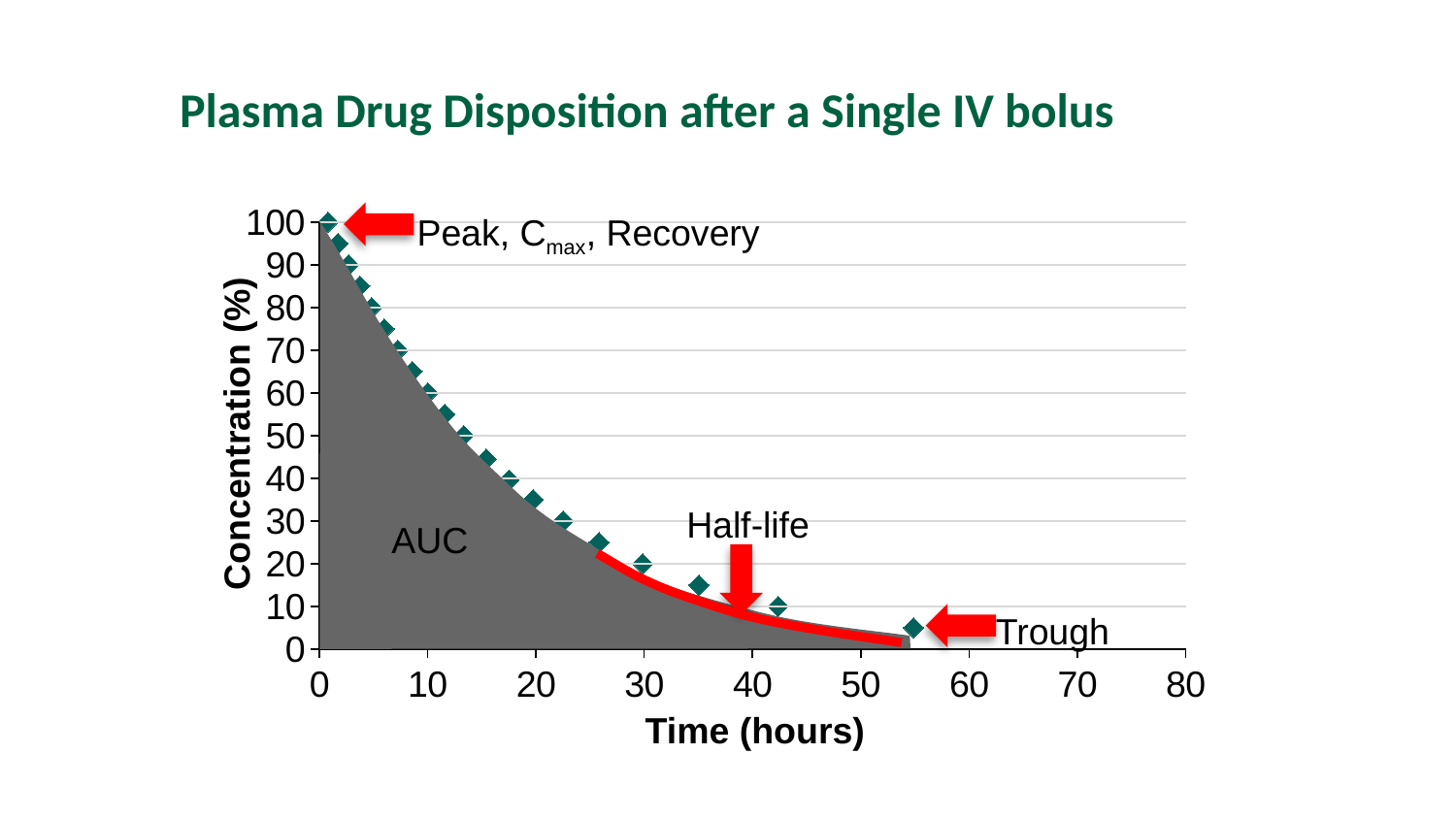
At which time (hours) is the concentration highest? 0 Which has the higher concentration: 10 hours or 30 hours? 10 hours Is the concentration at 20 hours greater or less than 50? less What kind of chart is shown on the slide? area chart What is the label on the x axis? Time (hours) Do the concentration values rise or fall as time increases along the x axis? fall Is the concentration at 5 hours greater or less than 70? greater What is the highest value shown on the x axis? 80 What is the concentration (%) at time 0 hours? 100 Is the concentration at 40 hours greater or less than 20? less What is the title of the chart? Plasma Drug Disposition after a Single IV bolus